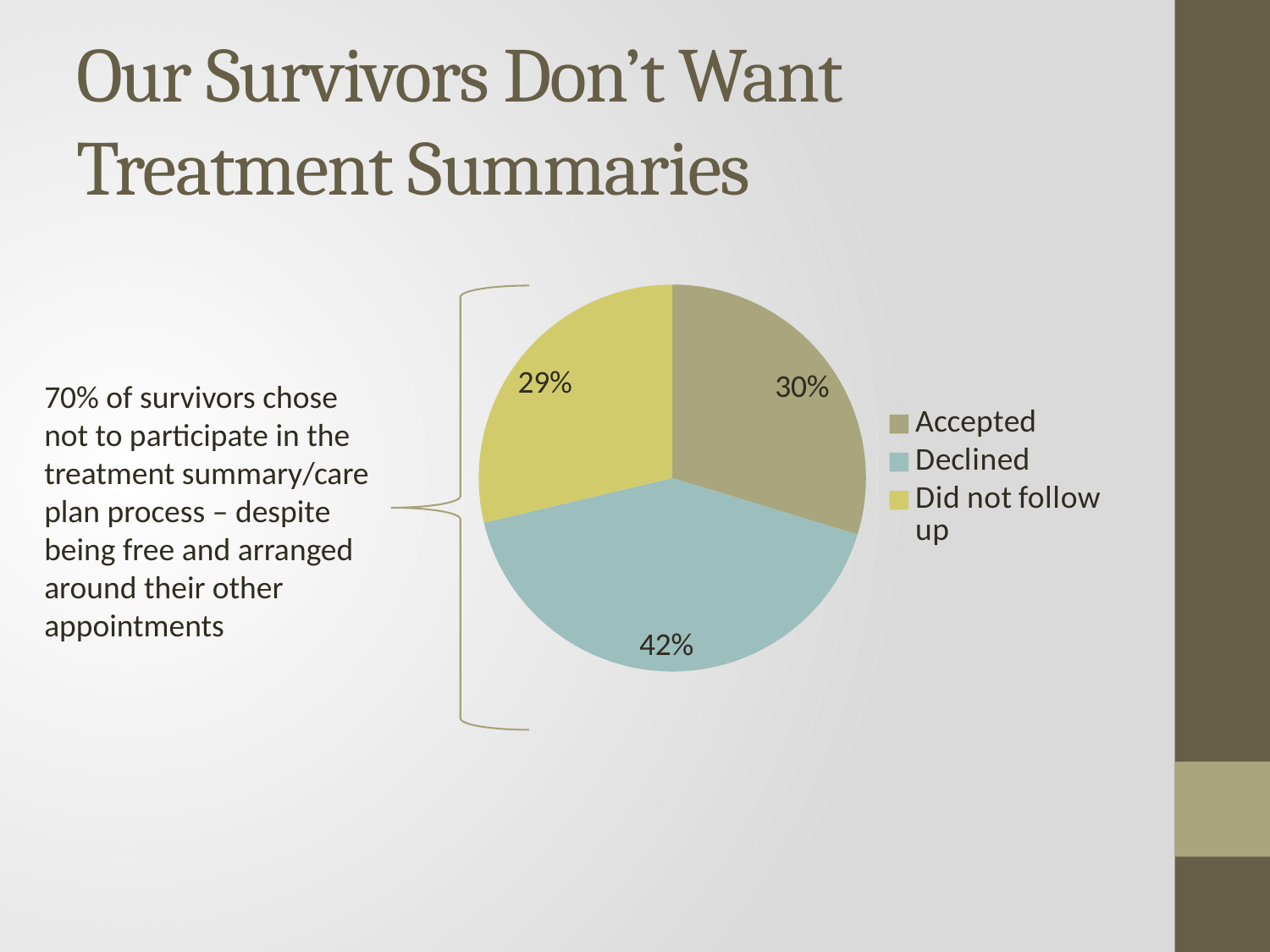
What is the difference in percentage points between Declined and Accepted? 12 What percentage of survivors Declined? 42% How many slices does the pie chart have? 3 Which category has the largest share of the pie? Declined Which is larger, the share for Accepted or the share for Did not follow up? Accepted What is the combined percentage for Declined and Did not follow up? 71% Which legend entry is shown in blue-green? Declined How many entries does the legend list? 3 What percentage of survivors Accepted? 30% What kind of chart is shown on the slide? pie chart Which category has the smallest share of the pie? Did not follow up What percentage of survivors Did not follow up? 29%